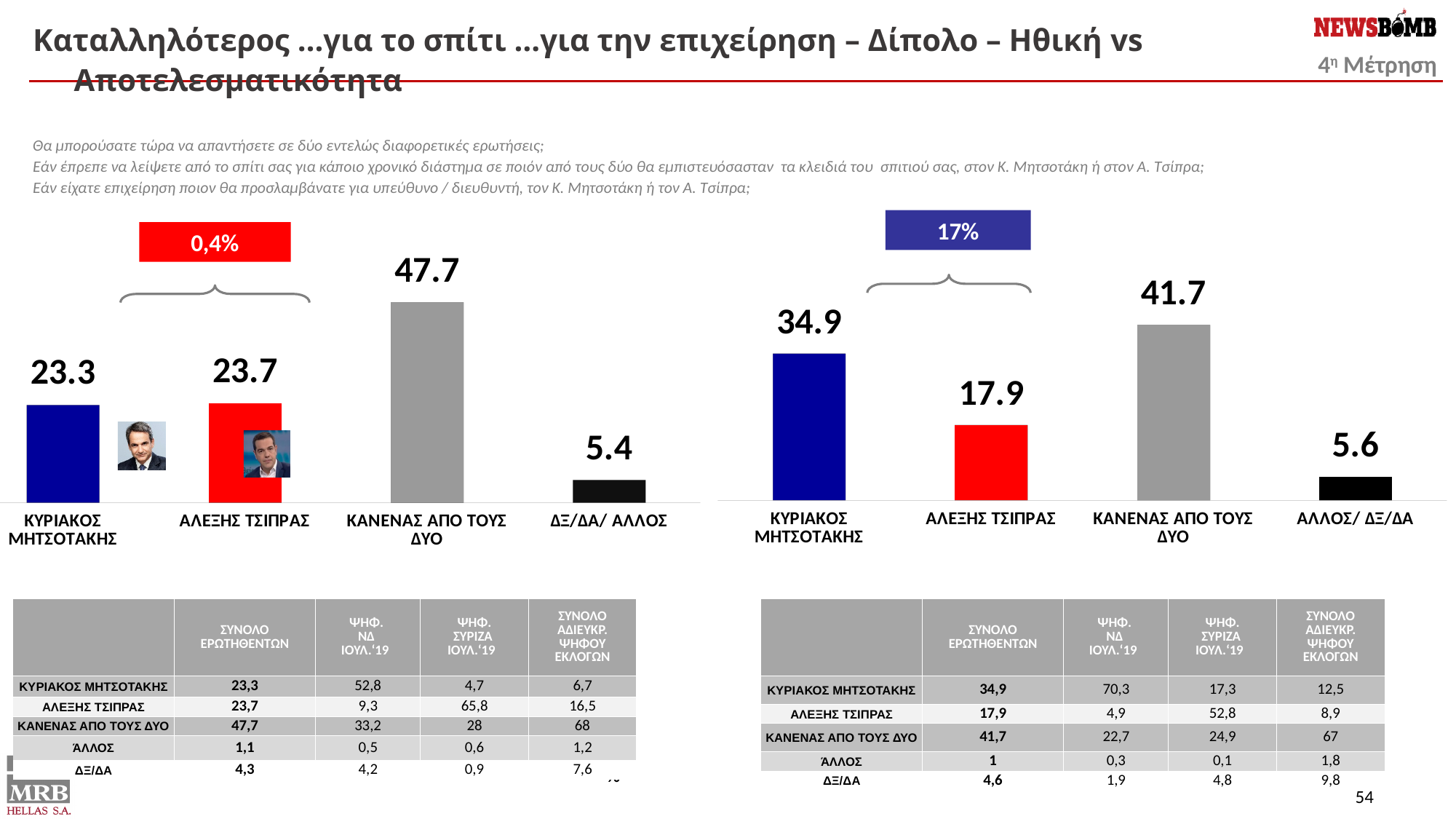
How many categories does the left chart show? 4 In the left chart, what value is shown in the red box above the bracket between ΚΥΡΙΑΚΟΣ ΜΗΤΣΟΤΑΚΗΣ and ΑΛΕΞΗΣ ΤΣΙΠΡΑΣ? 0,4% In the left chart, what is the value for ΑΛΕΞΗΣ ΤΣΙΠΡΑΣ? 23.7 In the left chart, what is the value for ΚΑΝΕΝΑΣ ΑΠΟ ΤΟΥΣ ΔΥΟ? 47.7 What kind of chart is the right chart? bar chart In the left chart, what is the difference between the values for ΚΑΝΕΝΑΣ ΑΠΟ ΤΟΥΣ ΔΥΟ and ΔΞ/ΔΑ/ ΑΛΛΟΣ? 42.3 In the right chart, what is the value for ΚΥΡΙΑΚΟΣ ΜΗΤΣΟΤΑΚΗΣ? 34.9 In the right chart, which is larger: the value for ΚΥΡΙΑΚΟΣ ΜΗΤΣΟΤΑΚΗΣ or the value for ΑΛΕΞΗΣ ΤΣΙΠΡΑΣ? ΚΥΡΙΑΚΟΣ ΜΗΤΣΟΤΑΚΗΣ In the left chart, which category has the highest value? ΚΑΝΕΝΑΣ ΑΠΟ ΤΟΥΣ ΔΥΟ In the right chart, what is the difference between the values for ΚΥΡΙΑΚΟΣ ΜΗΤΣΟΤΑΚΗΣ and ΑΛΕΞΗΣ ΤΣΙΠΡΑΣ? 17 In the right chart, which category has the lowest value? ΑΛΛΟΣ/ ΔΞ/ΔΑ In the right chart, what is the value for ΑΛΛΟΣ/ ΔΞ/ΔΑ? 5.6